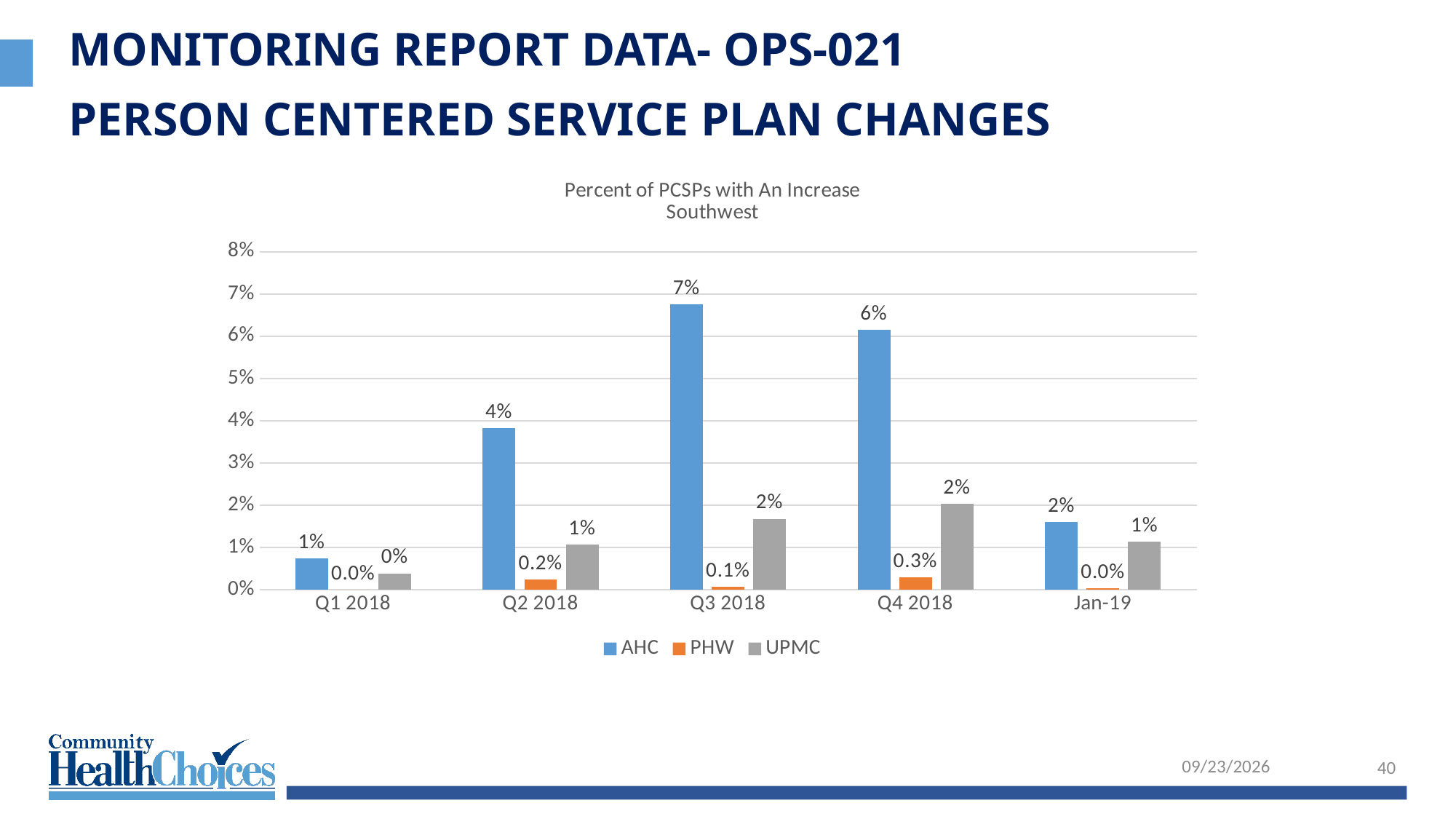
Is the value for UPMC in Q3 2018 greater or less than 1%? greater What is the value for AHC in Q3 2018? 7% How many periods are shown on the x axis? 5 How many series does the legend list? 3 In which period is the AHC value highest? Q3 2018 What is the difference between the AHC values for Q3 2018 and Q4 2018? 1% In which period is the PHW value highest? Q4 2018 What is the value for PHW in Q4 2018? 0.3% What kind of chart is shown on the slide? bar chart What is the value for UPMC in Jan-19? 1% In which period is the AHC value lowest? Q1 2018 Which is larger in Q2 2018, the AHC value or the UPMC value? AHC